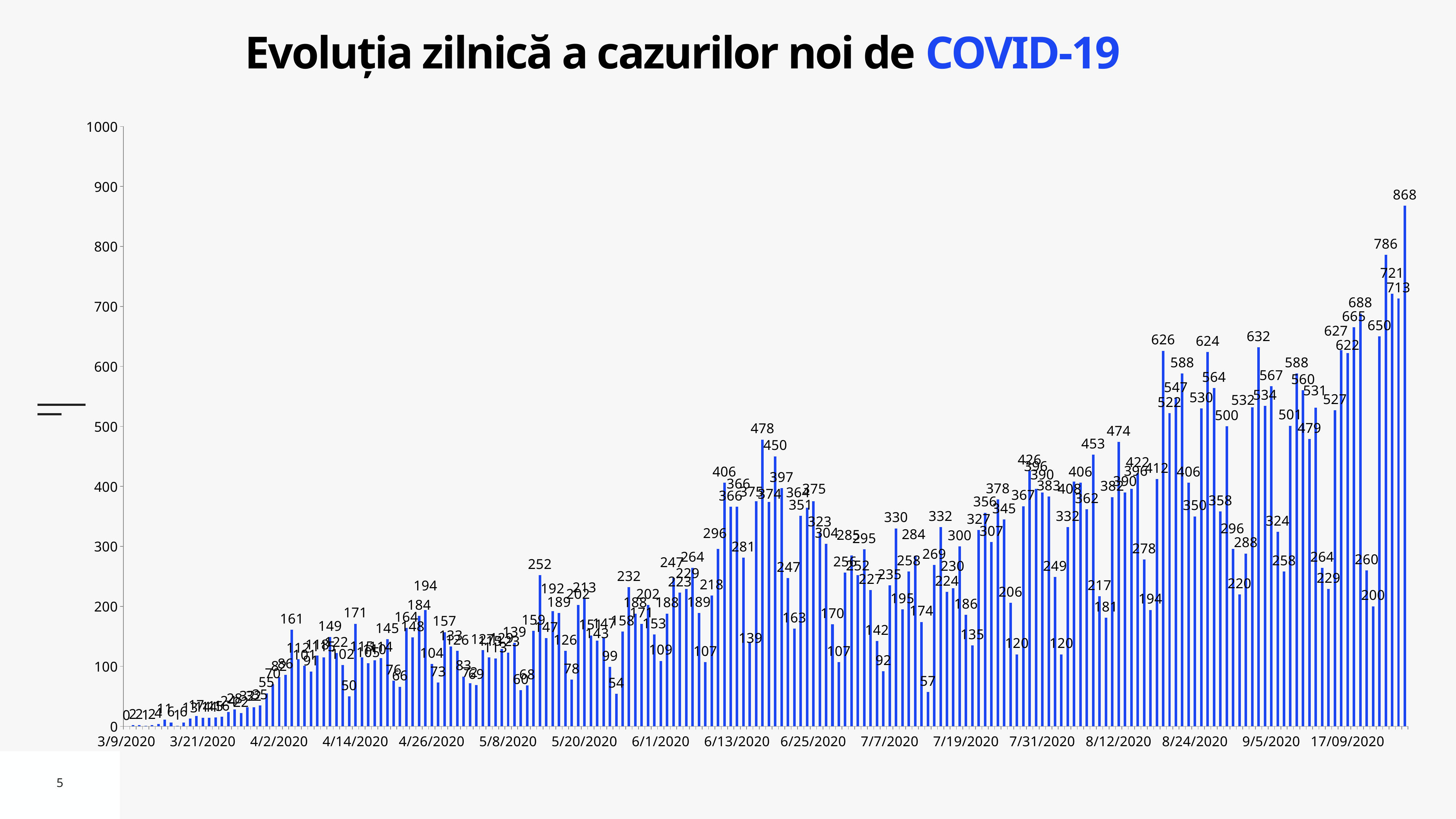
What is the second-highest value labelled on the chart? 786 What kind of chart is shown on the slide? bar chart What is the highest value labelled on the chart? 868 Is the tallest bar on the chart greater or less than 800? greater Which is larger, the tallest bar between 6/13/2020 and 6/25/2020 or the tallest bar after 17/09/2020? the tallest bar after 17/09/2020 What is the title of the chart? Evoluția zilnică a cazurilor noi de COVID-19 What is the value of the tallest bar between 5/8/2020 and 5/20/2020? 252 What is the value of the last bar on the right of the chart? 868 What is the value of the tallest bar between 6/13/2020 and 6/25/2020? 478 What is the maximum value shown on the vertical axis? 1000 Overall, do the daily values rise or fall from left to right along the x axis? rise What is the difference between the highest labelled value (868) and the second-highest (786)? 82